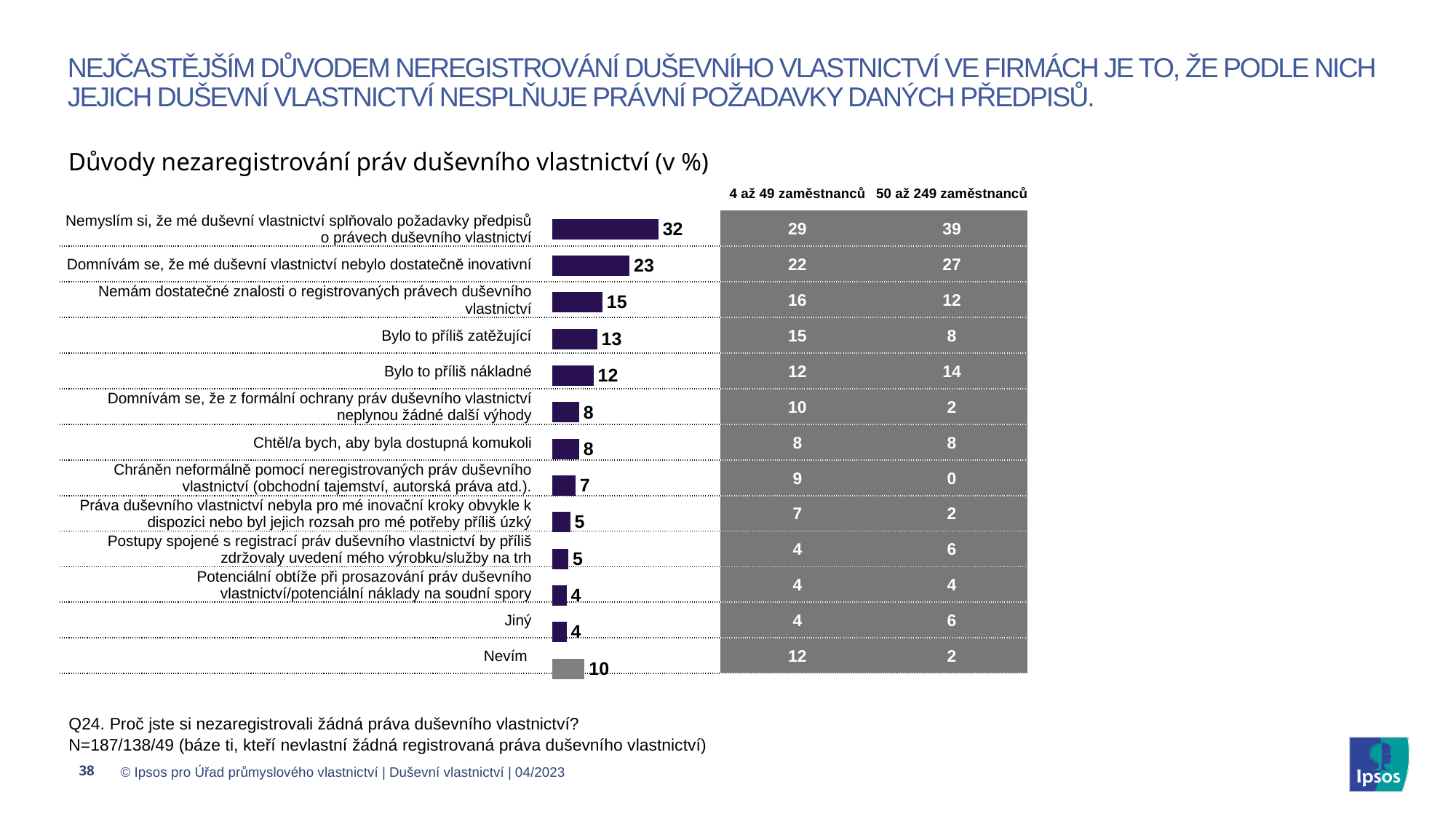
How many categories are shown in the bar chart? 13 What is the value for "Nevím"? 10 What is the difference between the values for "Nemám dostatečné znalosti o registrovaných právech duševního vlastnictví" and "Jiný"? 11 What is the value for "Domnívám se, že mé duševní vlastnictví nebylo dostatečně inovativní"? 23 What is the difference between the values for "Nemyslím si, že mé duševní vlastnictví splňovalo požadavky předpisů o právech duševního vlastnictví" and "Domnívám se, že mé duševní vlastnictví nebylo dostatečně inovativní"? 9 What is the value for "Chráněn neformálně pomocí neregistrovaných práv duševního vlastnictví (obchodní tajemství, autorská práva atd.)"? 7 Which bar in the chart is coloured grey rather than dark purple? Nevím Which category has the highest value in the bar chart? Nemyslím si, že mé duševní vlastnictví splňovalo požadavky předpisů o právech duševního vlastnictví What is the value for "Bylo to příliš zatěžující"? 13 What kind of chart is shown on the slide? Bar chart Which is larger: the value for "Bylo to příliš nákladné" or the value for "Chtěl/a bych, aby byla dostupná komukoli"? Bylo to příliš nákladné What is the title of the chart? Důvody nezaregistrování práv duševního vlastnictví (v %)